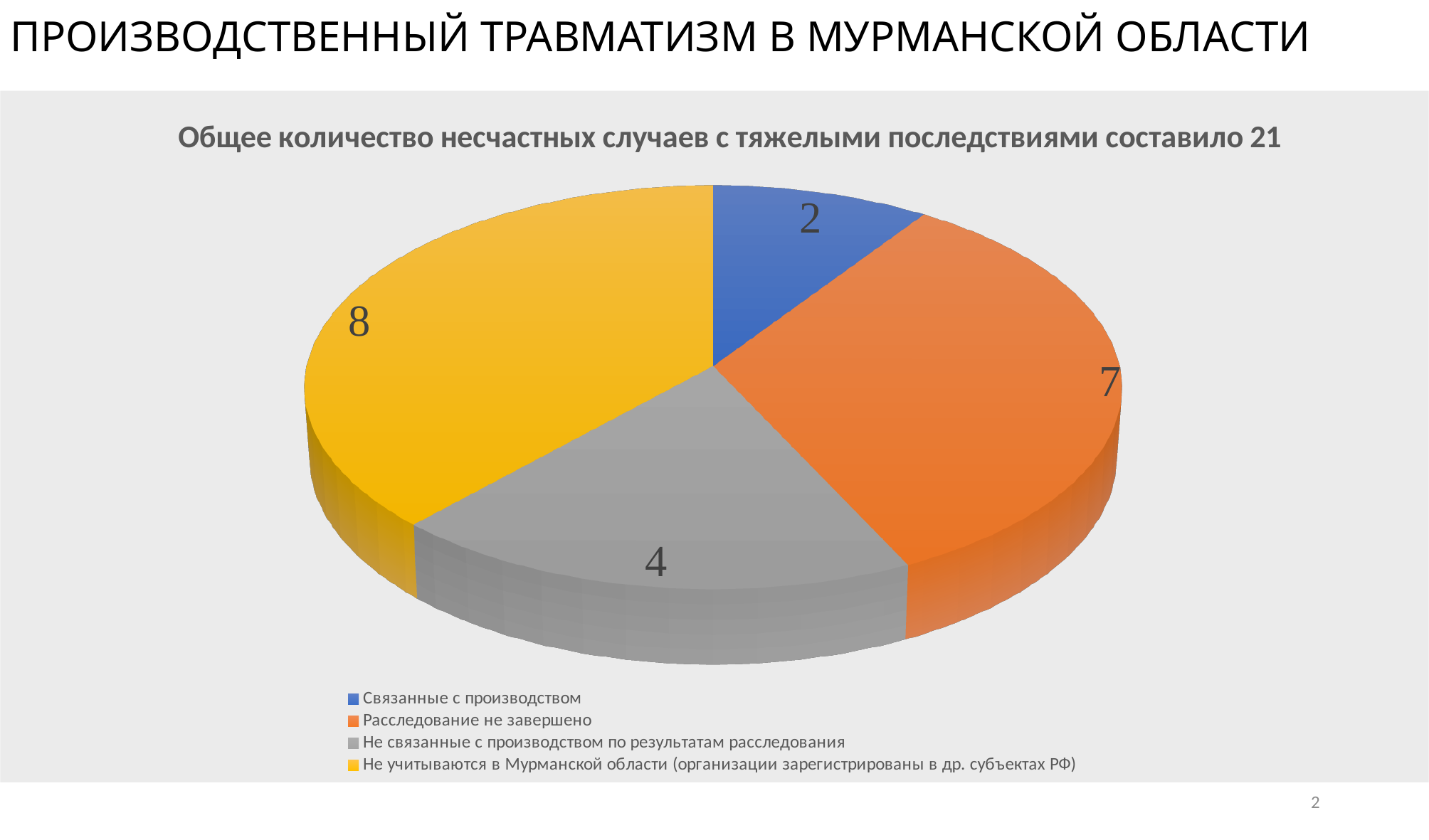
Which category has the smallest slice of the pie? Связанные с производством What is the value for "Расследование не завершено"? 7 Which category has the largest slice of the pie? Не учитываются в Мурманской области (организации зарегистрированы в др. субъектах РФ) What kind of chart is shown on the slide? Pie chart How many slices does the pie chart have? 4 What is the difference between the values for "Расследование не завершено" and "Связанные с производством"? 5 What is the value for "Не учитываются в Мурманской области (организации зарегистрированы в др. субъектах РФ)"? 8 What is the value for "Связанные с производством"? 2 What is the value for "Не связанные с производством по результатам расследования"? 4 What is the total of all slices in the pie chart? 21 What is the title of the chart? Общее количество несчастных случаев с тяжелыми последствиями составило 21 Which is larger: "Расследование не завершено" or "Не связанные с производством по результатам расследования"? Расследование не завершено